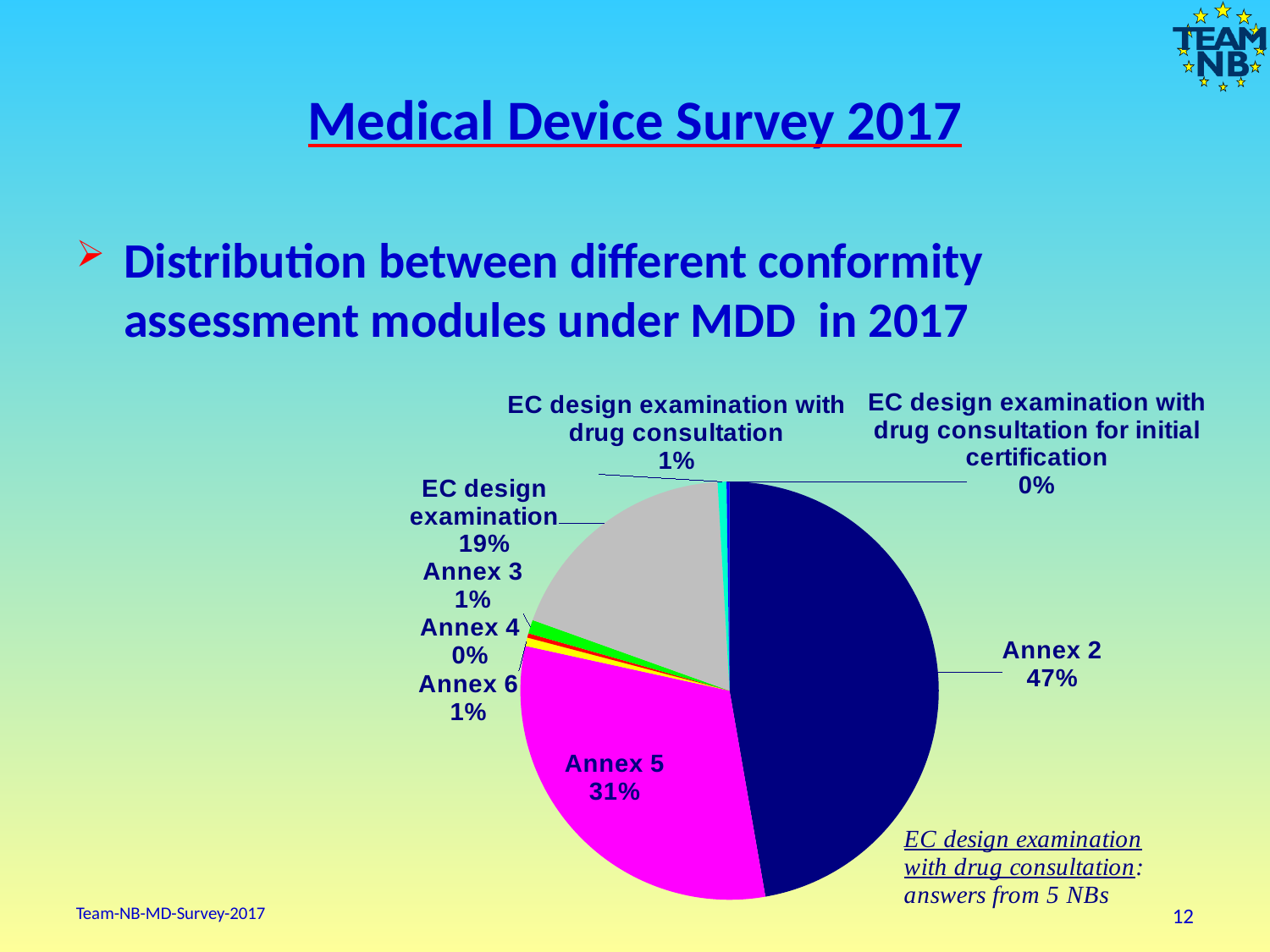
What is the value shown for EC design examination? 19% What share of the pie does Annex 2 represent? 47% What is the value shown for Annex 5? 31% Which is larger, the share for Annex 5 or the share for EC design examination? Annex 5 What is the difference in percentage points between Annex 2 and Annex 5? 16 What is the value shown for EC design examination with drug consultation for initial certification? 0% What colour is the Annex 5 slice? magenta Which category has the largest share of the pie? Annex 2 How many categories are labelled on the pie chart? 8 What kind of chart is shown on the slide? pie chart What is the value shown for Annex 4? 0% What is the value shown for Annex 3? 1%